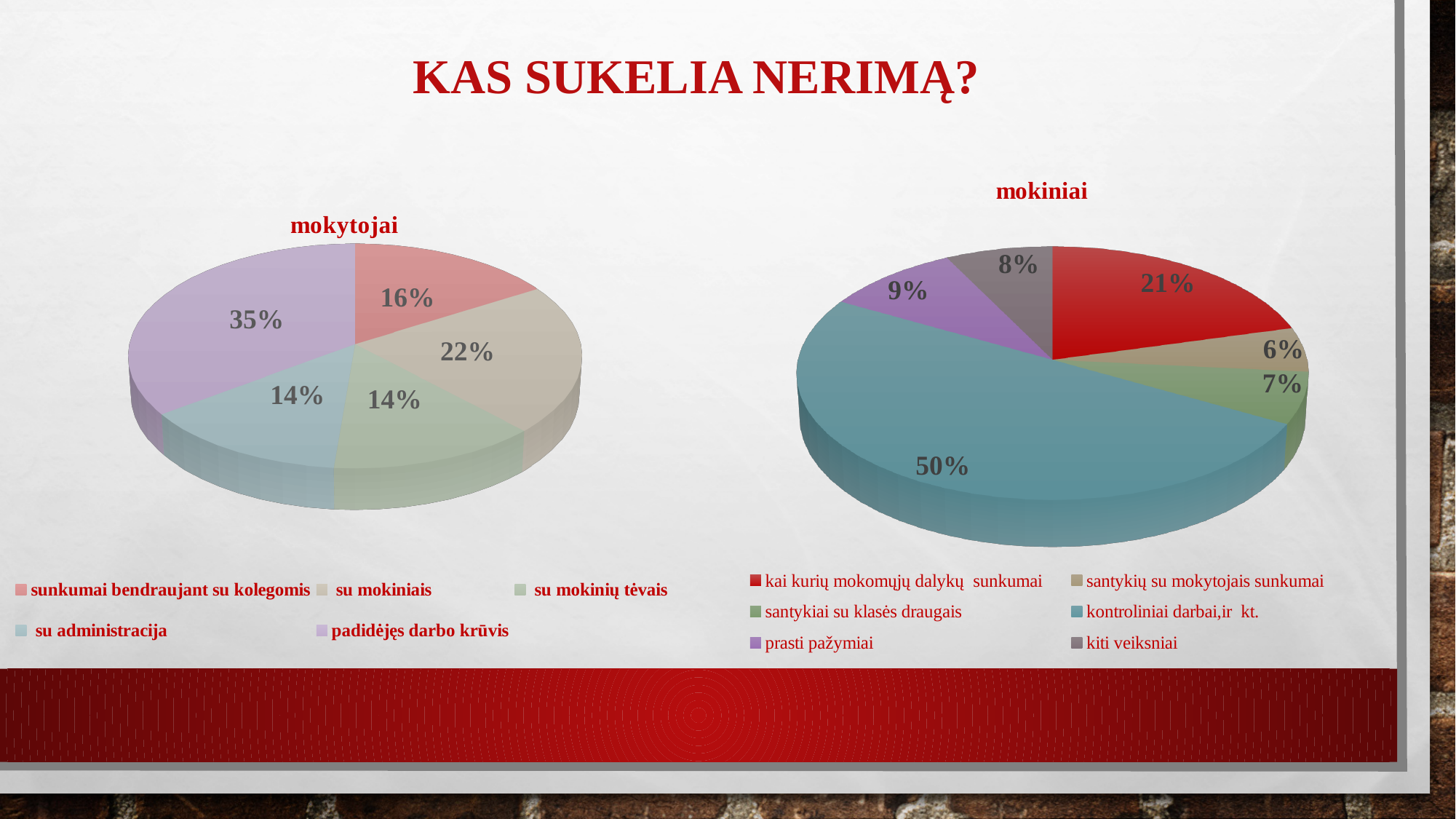
In the "mokiniai" pie chart, how many categories does the legend list? 6 In the "mokiniai" pie chart, which category has the smallest slice? santykių su mokytojais sunkumai In the "mokytojai" pie chart, how many slices does the pie have? 5 In the "mokytojai" pie chart, what share is labelled for "su mokiniais"? 22% In the "mokytojai" pie chart, which category has the largest slice? padidėjęs darbo krūvis What type of chart is used for both "mokytojai" and "mokiniai"? Pie chart What is the title of the slide above the two charts? KAS SUKELIA NERIMĄ? In the "mokytojai" pie chart, what is the difference between the "su mokiniais" slice and the "sunkumai bendraujant su kolegomis" slice? 6% In the "mokiniai" pie chart, what share is labelled for "prasti pažymiai"? 9% In the "mokytojai" pie chart, what share is labelled for "padidėjęs darbo krūvis"? 35% In the "mokiniai" pie chart, which is larger: "kai kurių mokomųjų dalykų sunkumai" or "kiti veiksniai"? kai kurių mokomųjų dalykų sunkumai In the "mokiniai" pie chart, what share is labelled for "kontroliniai darbai,ir kt."? 50%